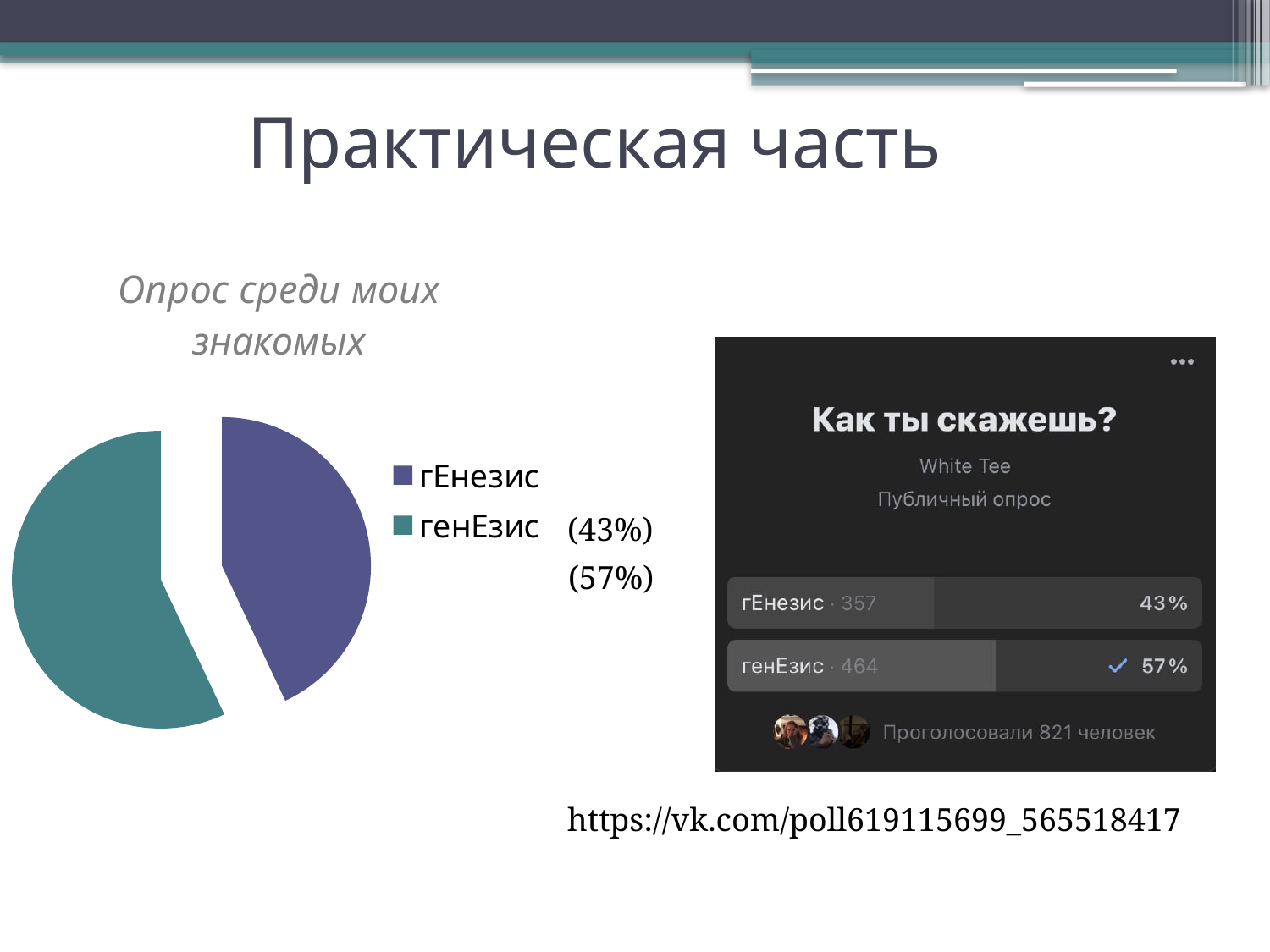
In the pie chart 'Опрос среди моих знакомых', what value is shown for генЕзис? 57% What type of chart is shown on the left side of the slide under the heading 'Опрос среди моих знакомых'? Pie chart In the pie chart 'Опрос среди моих знакомых', by how many percentage points does генЕзис exceed гЕнезис? 14 percentage points In the pie chart 'Опрос среди моих знакомых', which category has the smallest slice? гЕнезис In the pie chart 'Опрос среди моих знакомых', what share of the pie does the slice for гЕнезис represent? 43% How many slices does the pie chart 'Опрос среди моих знакомых' have? 2 How many entries does the legend of the pie chart 'Опрос среди моих знакомых' list? 2 In the pie chart 'Опрос среди моих знакомых', which is larger: the slice for гЕнезис or the slice for генЕзис? генЕзис In the pie chart 'Опрос среди моих знакомых', which category has the largest slice? генЕзис In the pie chart 'Опрос среди моих знакомых', what colour is the slice for генЕзис? Teal